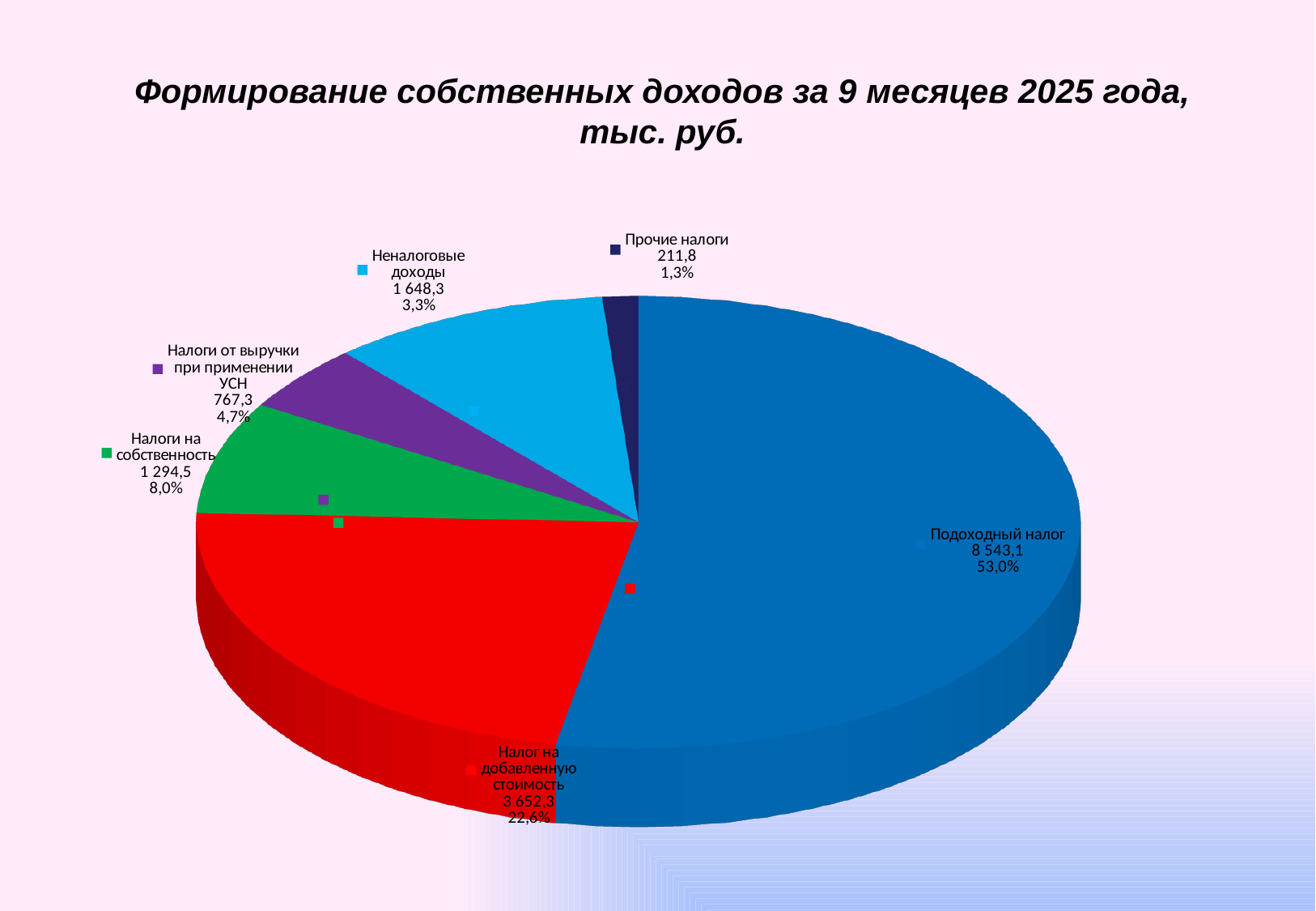
What is the value for Налог на добавленную стоимость? 3 652,3 What share of the pie does Налог на добавленную стоимость represent? 22,6% What is the difference between the values for Подоходный налог and Налог на добавленную стоимость? 4 890,8 Which category has the largest slice of the pie? Подоходный налог What is the value for Подоходный налог? 8 543,1 Which is larger, the value for Налоги на собственность or the value for Налоги от выручки при применении УСН? Налоги на собственность How many categories are shown in the pie chart? 6 What kind of chart is shown on the slide? Pie chart What share of the pie does Налоги от выручки при применении УСН represent? 4,7% What is the value for Налоги на собственность? 1 294,5 What is the value for Прочие налоги? 211,8 Which category has the smallest slice of the pie? Прочие налоги